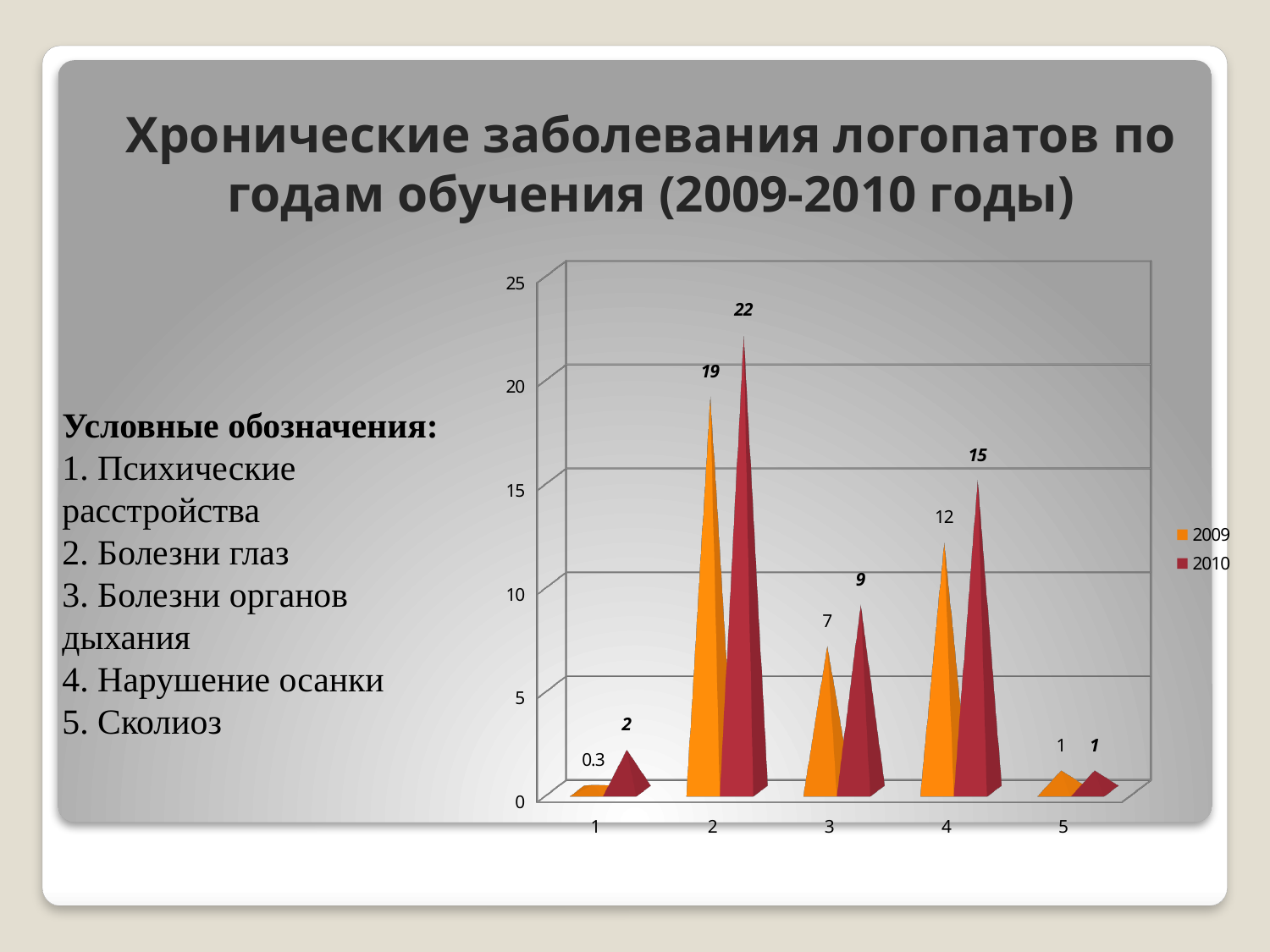
How many series does the legend list? 2 What is the value for category 3 in the 2010 series? 9 Which is larger for category 3: the 2009 value or the 2010 value? 2010 What is the value for category 4 in the 2010 series? 15 Which category has the highest value in the 2010 series? 2 Which category has the lowest value in the 2009 series? 1 What is the difference between the 2010 and 2009 values for category 4? 3 What is the value for category 2 in the 2009 series? 19 How many categories are shown on the x axis? 5 What is the value for category 1 in the 2009 series? 0.3 What kind of chart is shown on the slide? bar chart What is the difference between the 2010 and 2009 values for category 2? 3